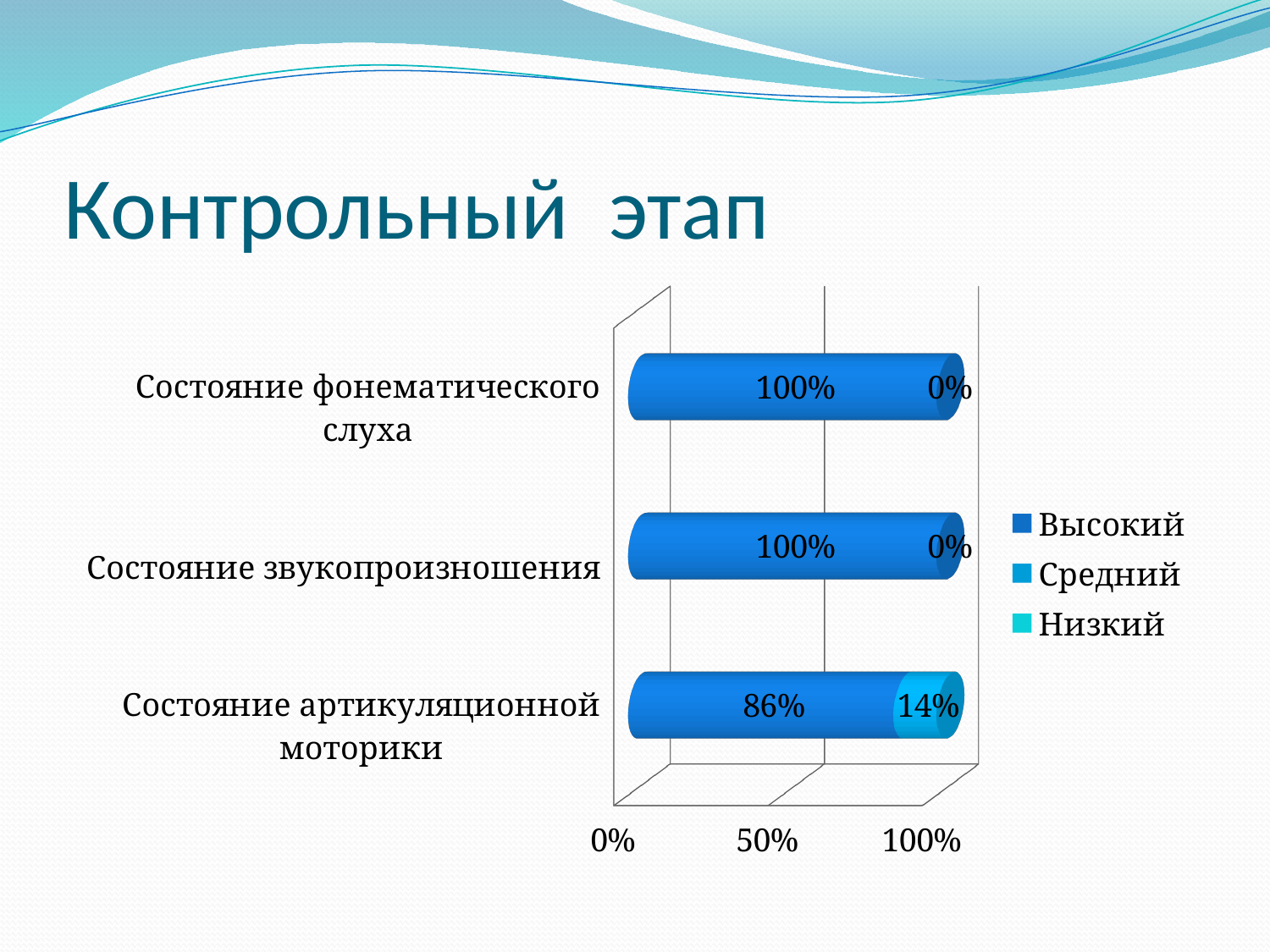
What is the value of Высокий for Состояние фонематического слуха? 100% What kind of chart is shown on the slide? bar chart What is the value of Высокий for Состояние звукопроизношения? 100% How many categories are shown on the chart? 3 Which category has the highest value for Средний? Состояние артикуляционной моторики How many series does the legend list? 3 Which category has the lowest value for Высокий? Состояние артикуляционной моторики What is the value of Высокий for Состояние артикуляционной моторики? 86% What is the value of Средний for Состояние звукопроизношения? 0% What is the difference between the Высокий and Средний values for Состояние артикуляционной моторики? 72% What is the value of Средний for Состояние артикуляционной моторики? 14% What is the title of the slide? Контрольный этап